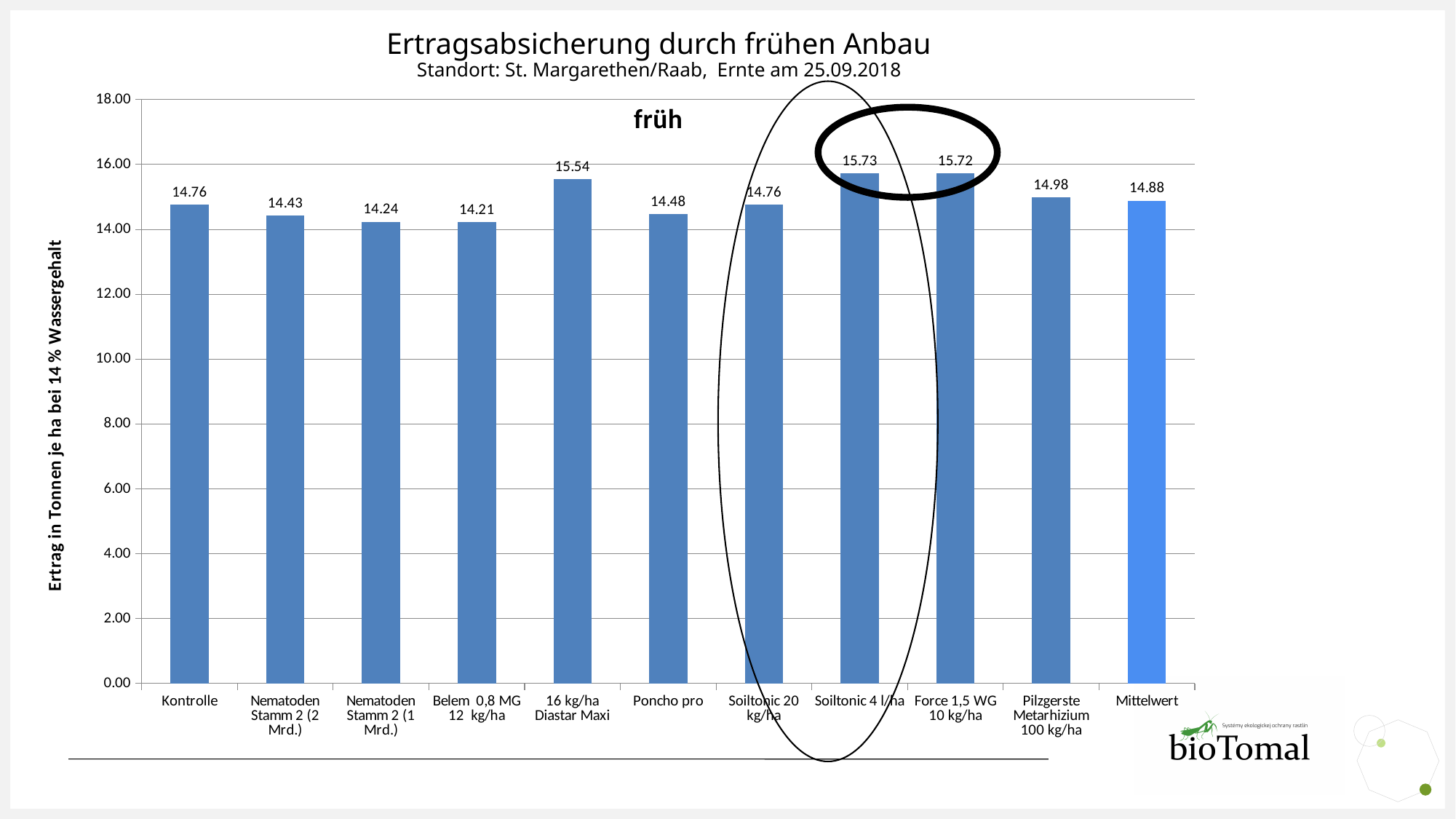
What is the value for 16 kg/ha Diastar Maxi? 15.54 What is the difference between the values for Soiltonic 4 l/ha and Kontrolle? 0.97 What is the title of the chart? früh Which is larger, the value for 16 kg/ha Diastar Maxi or the value for Belem 0,8 MG 12 kg/ha? 16 kg/ha Diastar Maxi What is the value for Kontrolle? 14.76 What is the value for Soiltonic 4 l/ha? 15.73 What kind of chart is shown on the slide? bar chart What is the difference between the values for Force 1,5 WG 10 kg/ha and Poncho pro? 1.24 What is the value for Pilzgerste Metarhizium 100 kg/ha? 14.98 What is the value for Mittelwert? 14.88 How many bars are shown in the chart? 11 Is the value for Nematoden Stamm 2 (1 Mrd.) greater or less than 16.00? less